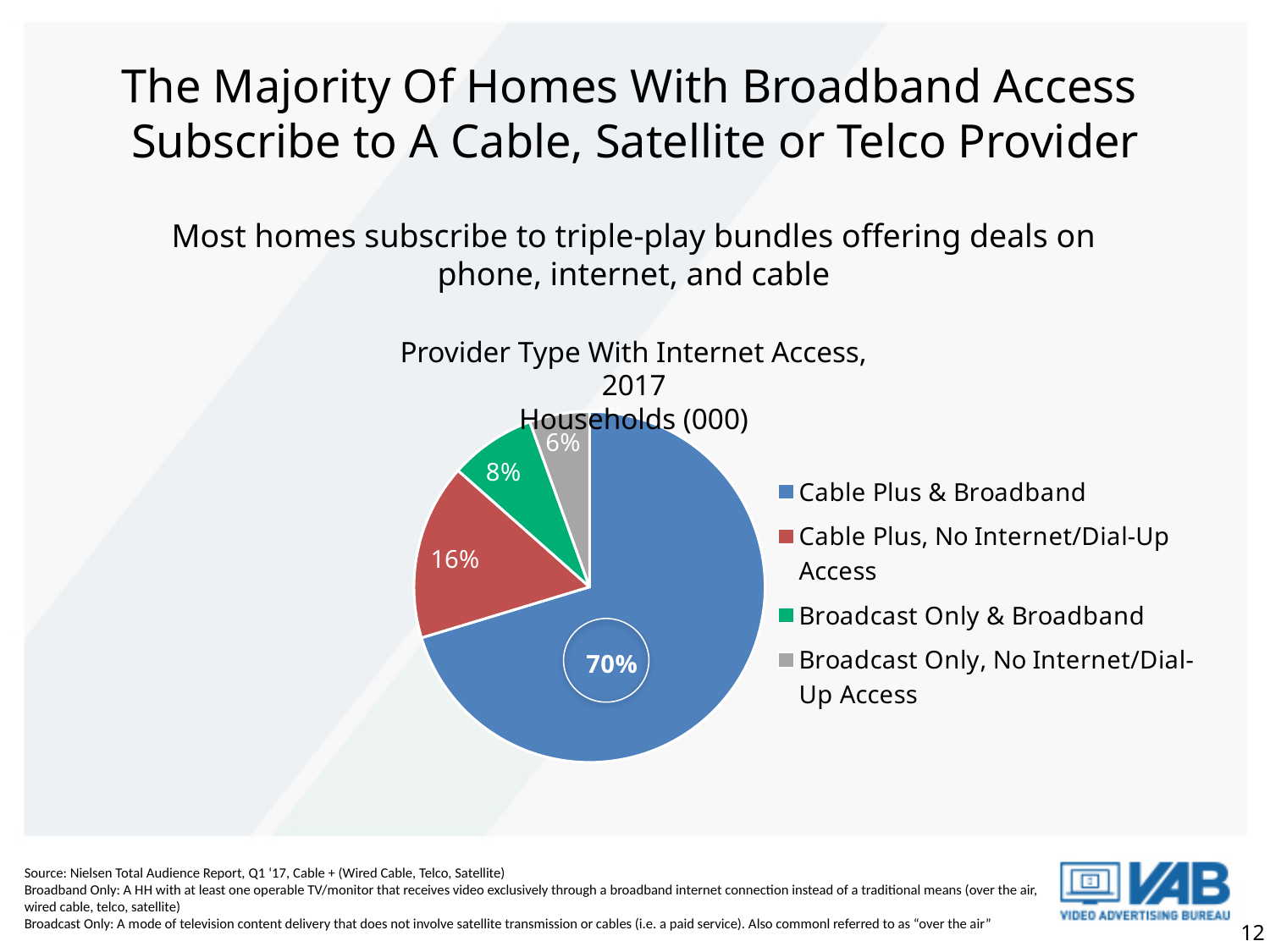
Which is larger: the share for Broadcast Only & Broadband or the share for Broadcast Only, No Internet/Dial-Up Access? Broadcast Only & Broadband What is the difference in percentage points between Cable Plus & Broadband and Cable Plus, No Internet/Dial-Up Access? 54 percentage points Which category has the largest slice of the pie? Cable Plus & Broadband What share of the pie does Broadcast Only & Broadband represent? 8% What share of the pie does Cable Plus, No Internet/Dial-Up Access represent? 16% Which category has the smallest slice of the pie? Broadcast Only, No Internet/Dial-Up Access What kind of chart is shown on the slide? pie chart How many categories does the pie chart show? 4 What is the title of the chart? Provider Type With Internet Access, 2017 Households (000) What share of the pie does Cable Plus & Broadband represent? 70% What colour is the slice for Cable Plus, No Internet/Dial-Up Access? red